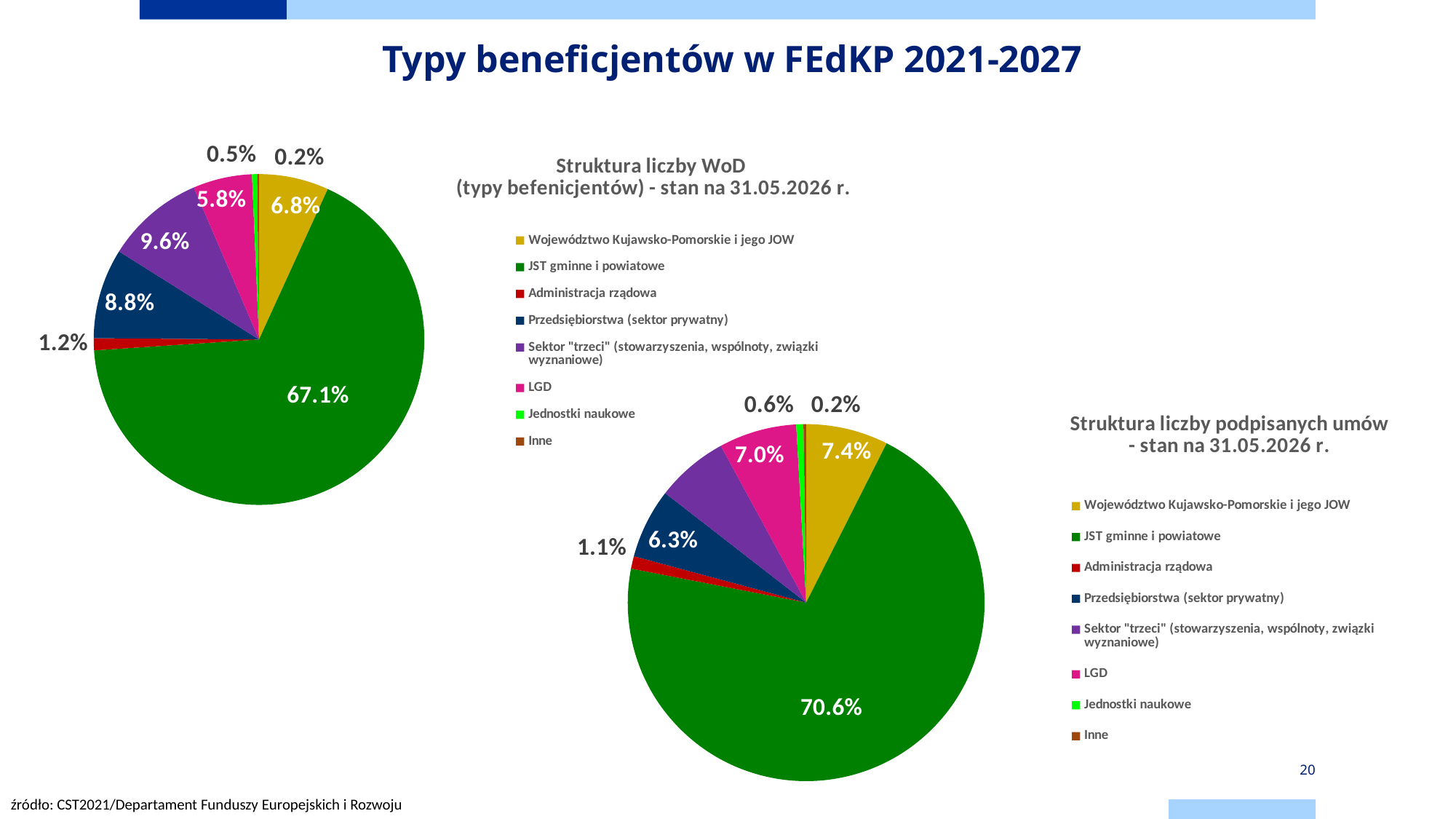
In the 'Struktura liczby WoD' pie chart, which category has the smallest slice? Inne In the 'Struktura liczby podpisanych umów' pie chart, what share is shown for JST gminne i powiatowe? 70.6% In the 'Struktura liczby podpisanych umów' pie chart, what share is shown for LGD? 7.0% In the 'Struktura liczby podpisanych umów' pie chart, what share is shown for Województwo Kujawsko-Pomorskie i jego JOW? 7.4% In the 'Struktura liczby WoD' pie chart, what is the difference between the shares of Sektor "trzeci" and LGD? 3.8% In the 'Struktura liczby WoD' pie chart, which category has the largest slice? JST gminne i powiatowe In the 'Struktura liczby WoD' pie chart, what share is shown for Sektor "trzeci"? 9.6% How many categories does the legend of the 'Struktura liczby podpisanych umów' chart list? 8 In the 'Struktura liczby WoD' pie chart, what share is shown for Przedsiębiorstwa (sektor prywatny)? 8.8% In the 'Struktura liczby podpisanych umów' pie chart, which is larger: the share for Przedsiębiorstwa (sektor prywatny) or the share for Administracja rządowa? Przedsiębiorstwa (sektor prywatny) What type of chart is used for 'Struktura liczby WoD'? Pie chart In the 'Struktura liczby WoD' pie chart, what share is shown for JST gminne i powiatowe? 67.1%